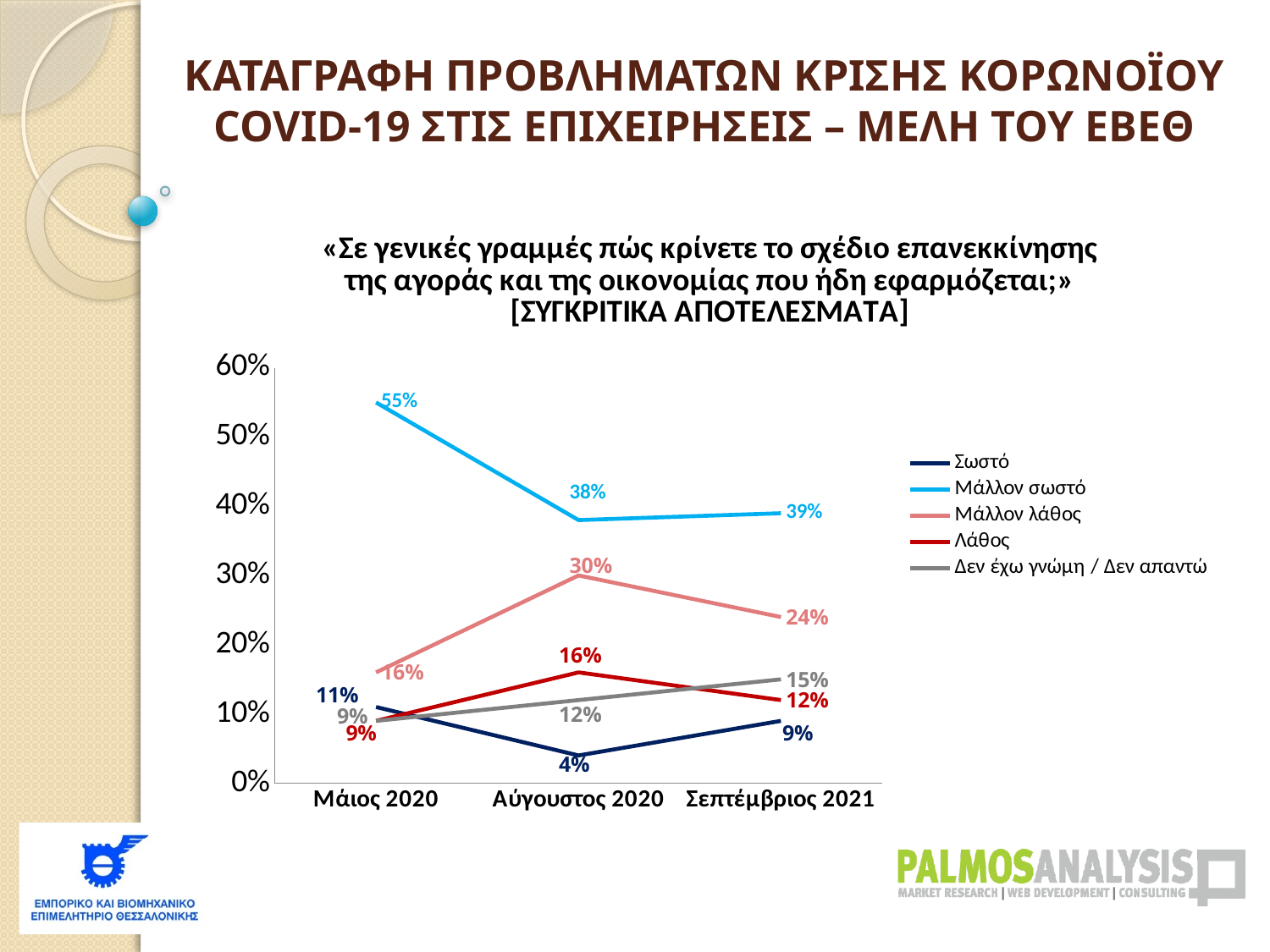
Which is larger in Σεπτέμβριος 2021: Λάθος or Δεν έχω γνώμη / Δεν απαντώ? Δεν έχω γνώμη / Δεν απαντώ Does the Δεν έχω γνώμη / Δεν απαντώ series rise or fall from Μάιος 2020 to Σεπτέμβριος 2021? rise What is the value for Σωστό in Αύγουστος 2020? 4% What is the value for Μάλλον σωστό in Μάιος 2020? 55% Which series has the lowest value in Αύγουστος 2020? Σωστό What is the value for Δεν έχω γνώμη / Δεν απαντώ in Σεπτέμβριος 2021? 15% What is the difference between the Μάλλον σωστό values in Μάιος 2020 and Αύγουστος 2020? 17% What is the value for Μάλλον λάθος in Αύγουστος 2020? 30% What kind of chart is shown on the slide? line chart How many time points are shown on the x axis? 3 How many series does the legend list? 5 Which series has the highest value in Μάιος 2020? Μάλλον σωστό